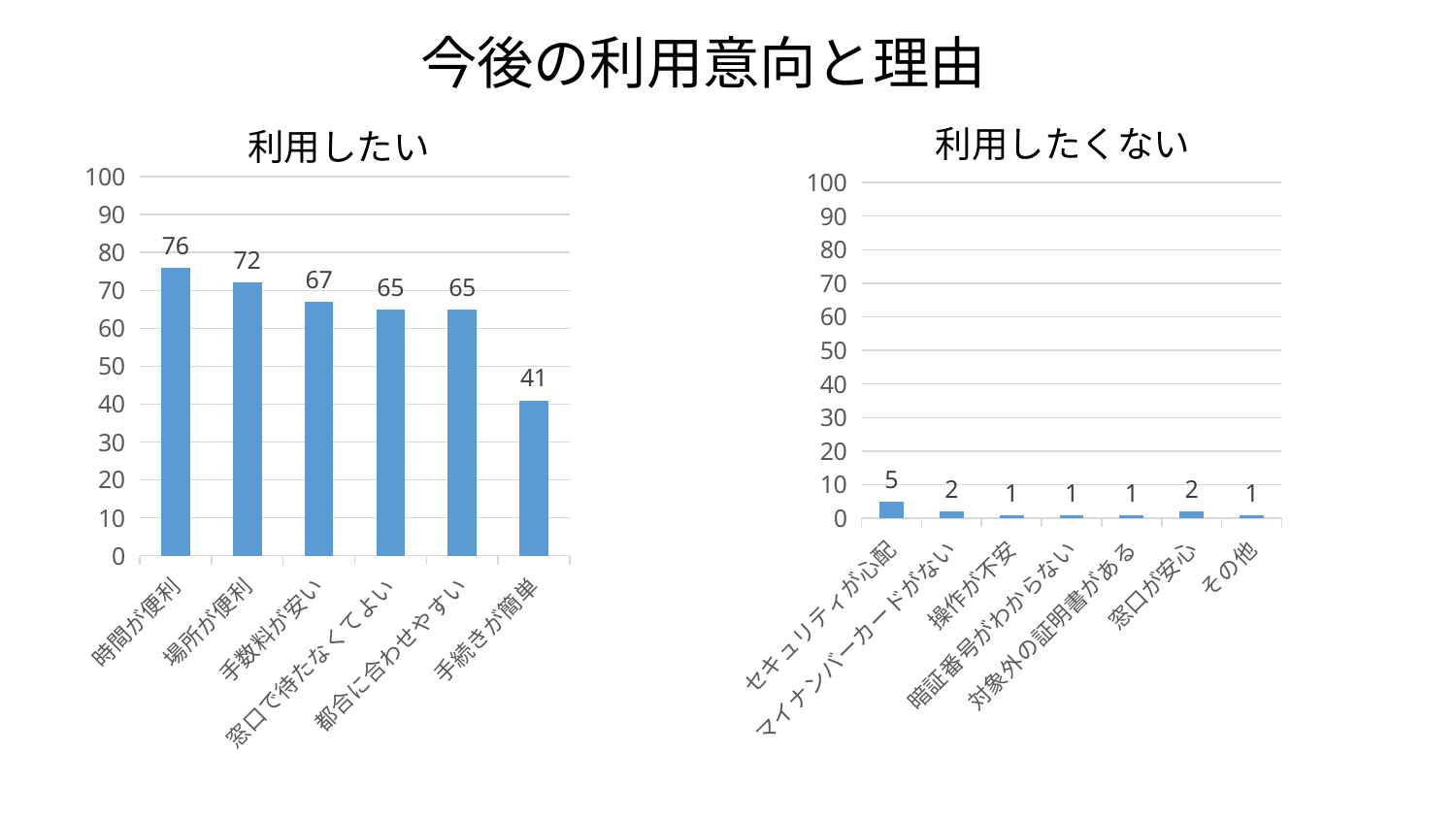
In the 利用したくない chart, what is the value for セキュリティが心配? 5 In the 利用したい chart, how many categories are shown? 6 In the 利用したい chart, which category has the lowest value? 手続きが簡単 In the 利用したい chart, which category has the highest value? 時間が便利 In the 利用したくない chart, how many categories are shown? 7 In the 利用したくない chart, what is the value for 窓口が安心? 2 What type of chart is the 利用したい chart? bar chart In the 利用したくない chart, which is larger, マイナンバーカードがない or 操作が不安? マイナンバーカードがない In the 利用したくない chart, which category has the highest value? セキュリティが心配 In the 利用したい chart, what is the value for 時間が便利? 76 In the 利用したい chart, what is the value for 手続きが簡単? 41 In the 利用したい chart, what is the difference between 場所が便利 and 手数料が安い? 5